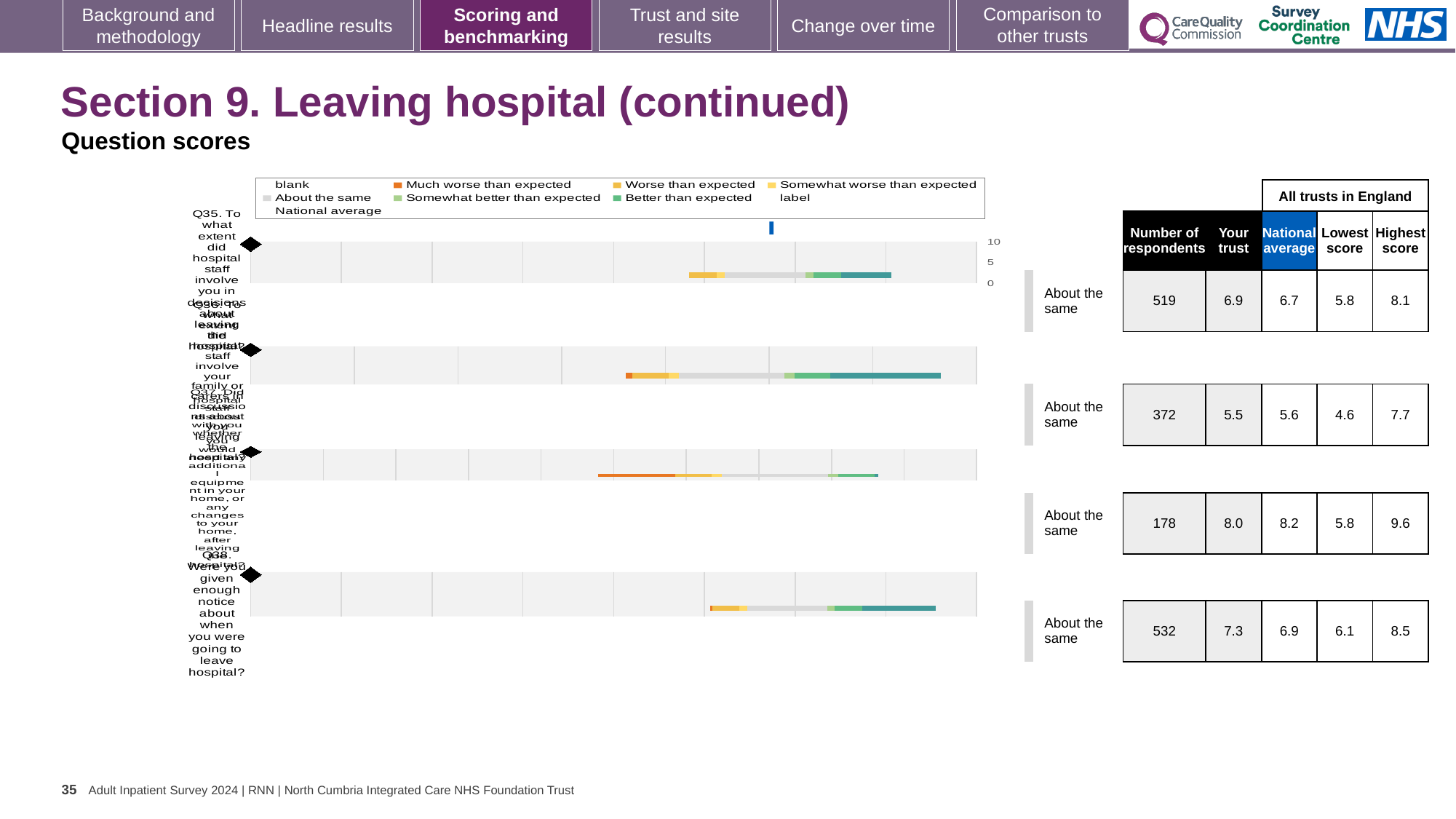
In the table beside the chart, what is the highest score for the second row (372 respondents)? 7.7 Which of the four rows has the highest 'Your trust' score in the table? the third row (8.0) In the table beside the chart, what is the national average for the third row (178 respondents)? 8.2 Which of the four rows has the lowest number of respondents in the table? the third row (178) How many question rows (Q35 to Q38) are plotted in the chart? 4 In the table beside the chart, what is the number of respondents for Q38 (the last row)? 532 What colour does the legend use for 'Much worse than expected'? orange What benchmark label is shown next to each of the four question rows? About the same In the table beside the chart, what is the 'Your trust' score for Q35 (the first row)? 6.9 What kind of chart is used to show the question scores on this slide? bar chart What is the difference between the 'Your trust' score and the national average for Q38 (the last row)? 0.4 For Q35 (the first row), is the 'Your trust' score or the national average larger? Your trust (6.9)